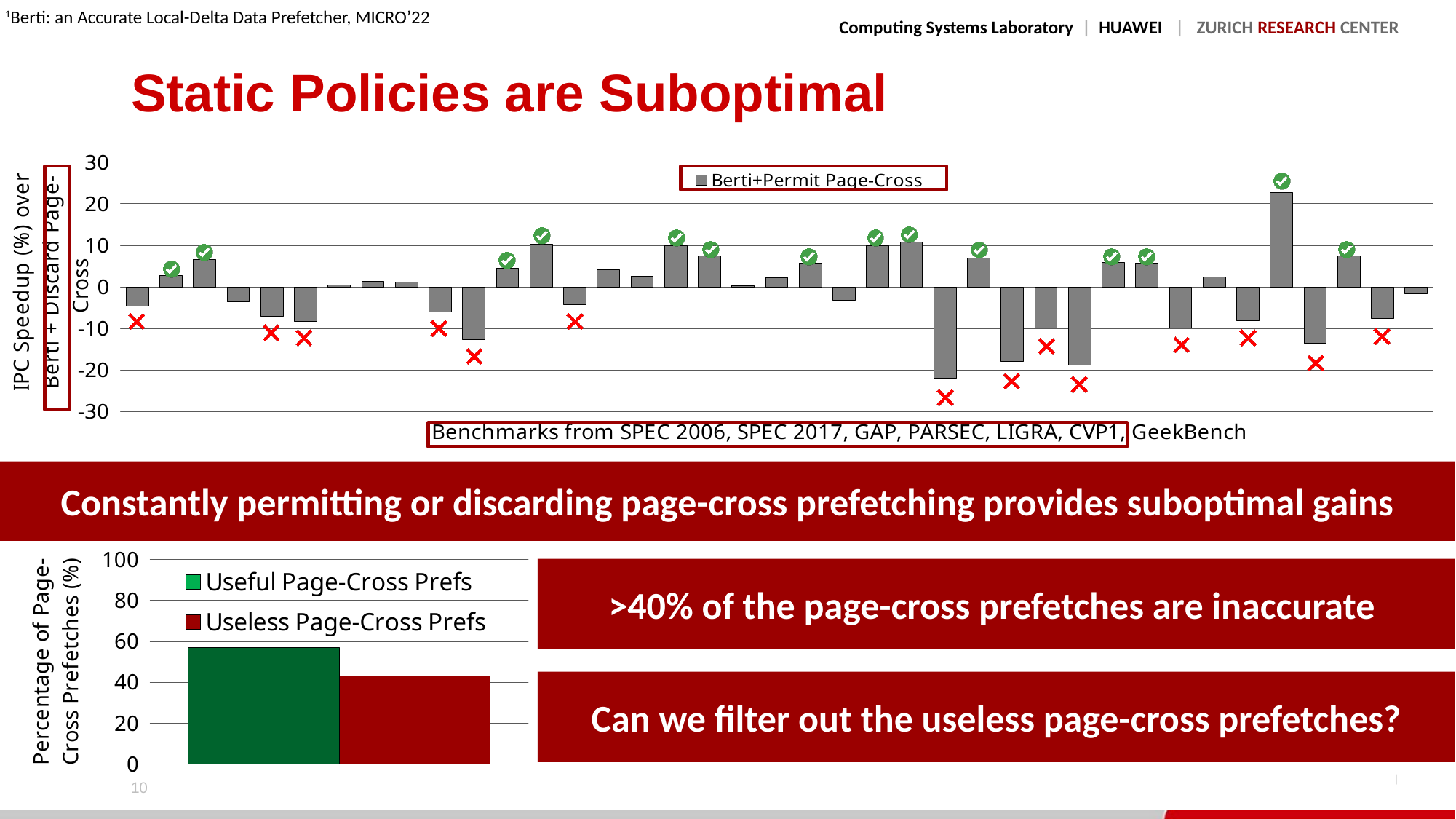
In the bottom-left chart, is the value for Useful Page-Cross Prefs greater or less than 60? less What type of chart is the top chart showing IPC speedup? bar chart In the top chart, is the value of the lowest bar greater or less than -20? less How many series does the legend of the bottom-left chart list? 2 What type of chart is the bottom-left chart showing the percentage of page-cross prefetches? bar chart In the bottom-left chart, which is larger: Useful Page-Cross Prefs or Useless Page-Cross Prefs? Useful Page-Cross Prefs In the bottom-left chart, is the value for Useless Page-Cross Prefs greater or less than 60? less What is the legend entry of the top chart? Berti+Permit Page-Cross How many series does the legend of the top chart list? 1 In the bottom-left chart, what colour is the bar for Useless Page-Cross Prefs? dark red